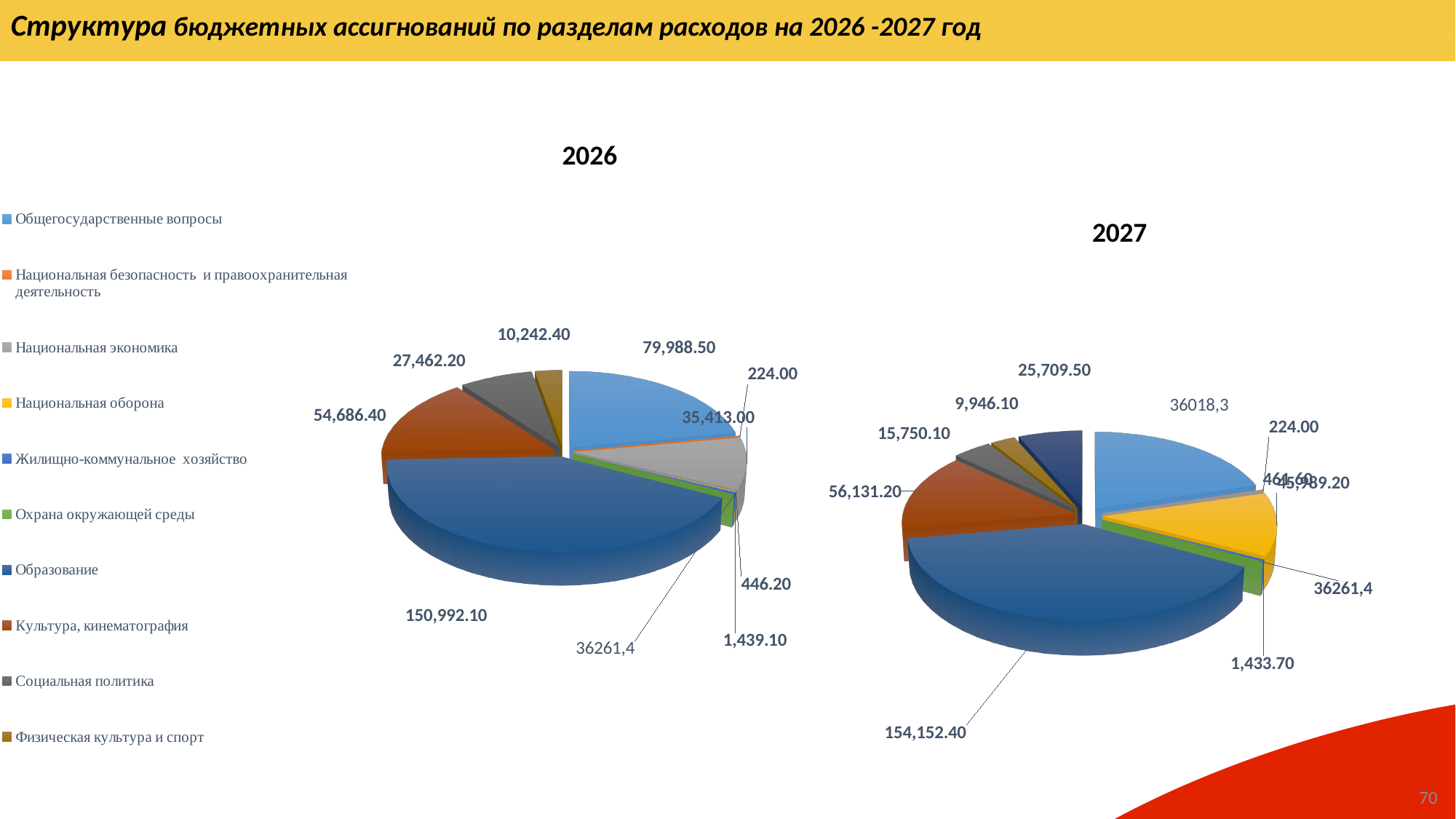
In the 2026 chart, what is the value for Культура, кинематография? 54,686.40 In the 2026 chart, what is the value for Социальная политика? 27,462.20 In the 2026 chart, which category has the largest slice? Образование In the 2026 chart, what is the value for Национальная безопасность и правоохранительная деятельность? 224.00 In the 2027 chart, what is the value of the largest slice? 154,152.40 In the 2026 chart, what is the value for Общегосударственные вопросы? 79,988.50 What type of charts are shown on the slide? Pie charts How many categories does the legend list? 10